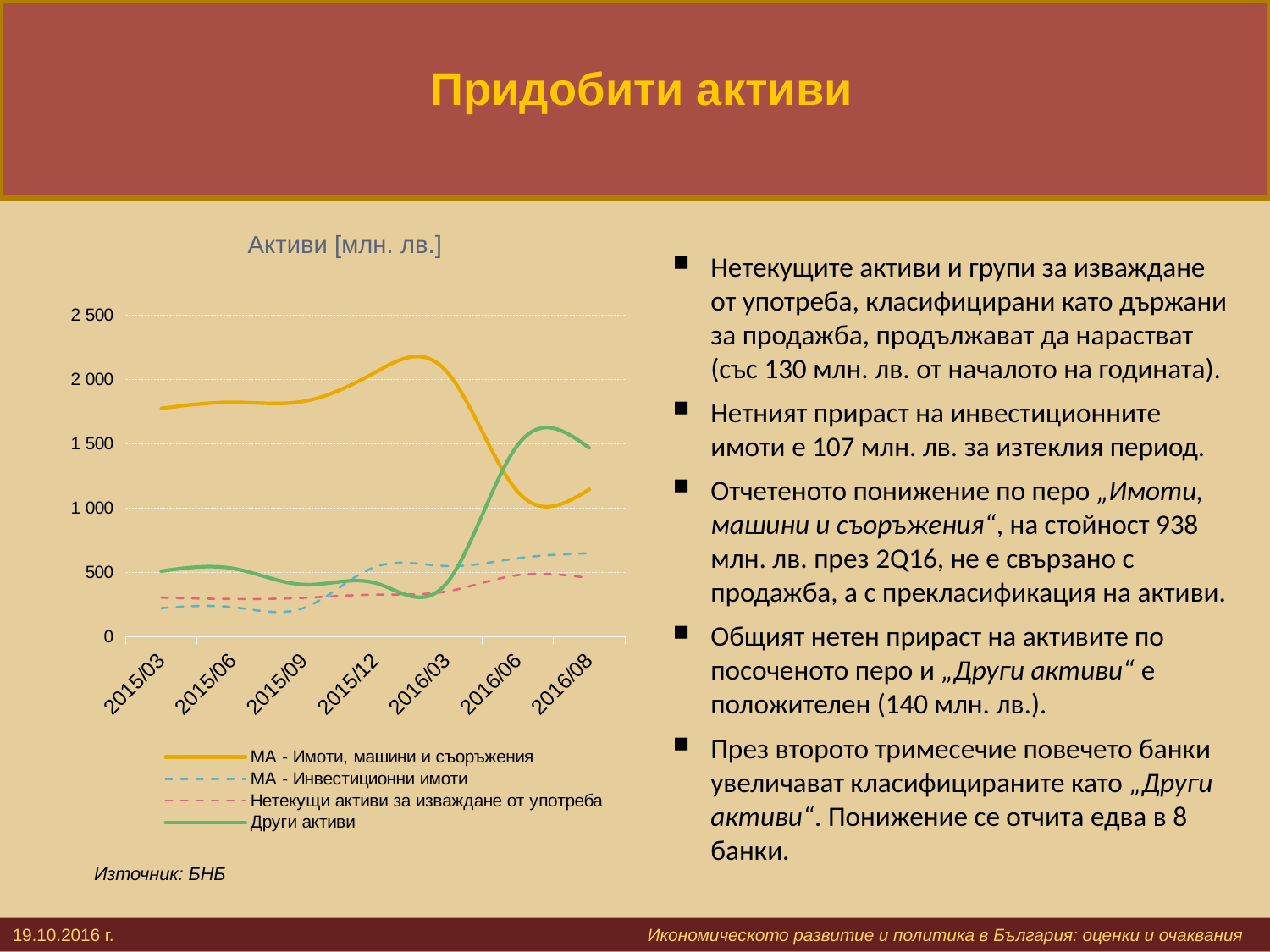
How many time points are labelled on the x axis of the chart? 7 Is the value for "МА - Имоти, машини и съоръжения" at 2015/03 greater or less than 1 500? greater Does the "МА - Имоти, машини и съоръжения" series rise or fall between 2016/03 and 2016/06? fall What kind of chart is shown on the slide? line chart What is the title of the chart? Активи [млн. лв.] How many series does the chart legend list? 4 At 2016/08, which is higher: "Други активи" or "МА - Имоти, машини и съоръжения"? Други активи Is the value for "Други активи" at 2016/06 greater or less than 1 000? greater Is the value for "МА - Инвестиционни имоти" at 2015/03 greater or less than 500? less What source is cited below the chart? БНБ Which series has the highest value at 2015/03? МА - Имоти, машини и съоръжения Does the "Други активи" series rise or fall between 2015/12 and 2016/06? rise